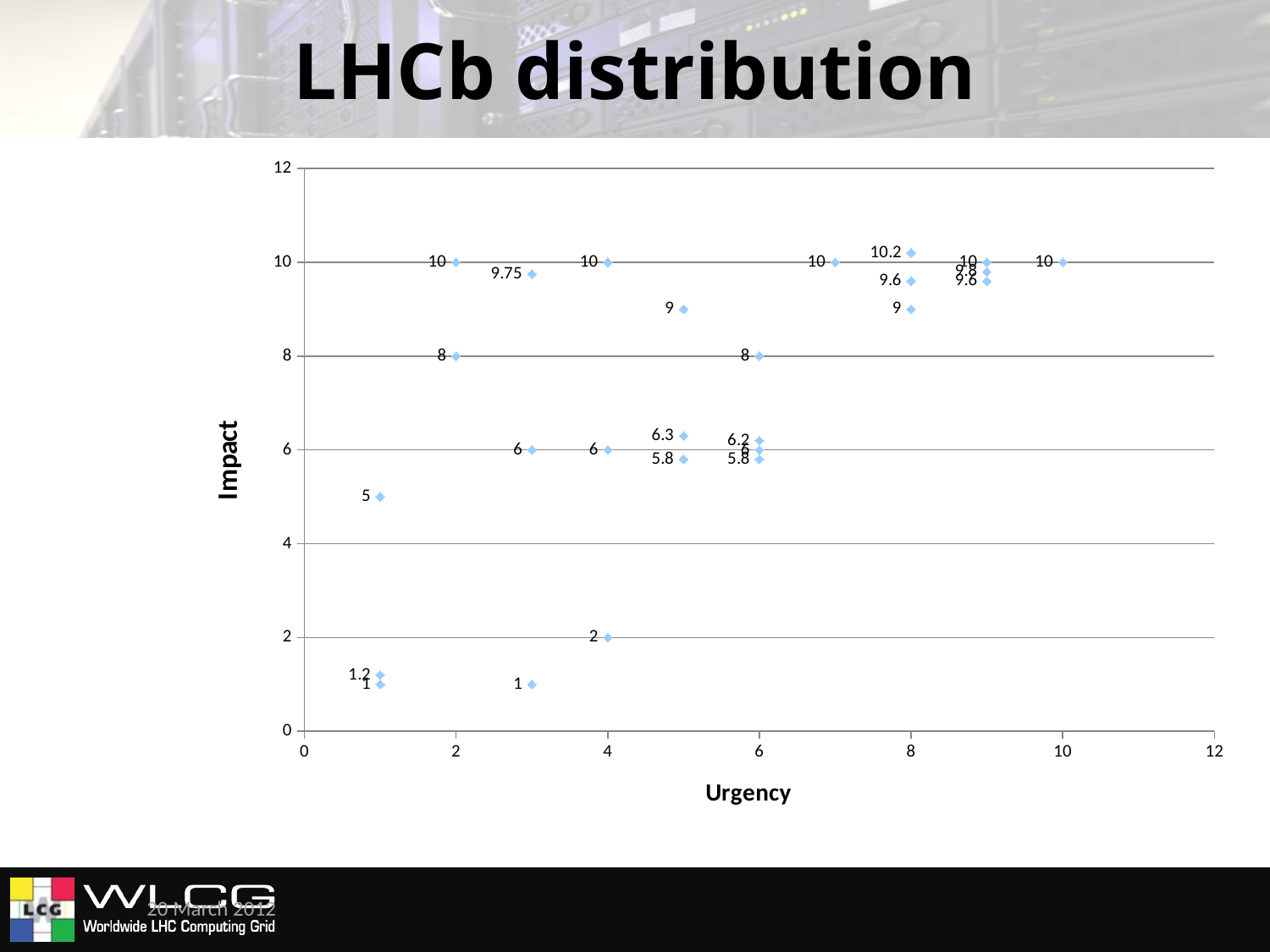
How many points are plotted at Urgency 6? 4 What is the title of the chart? LHCb distribution What is the Impact value of the point at Urgency 7? 10 Which is larger: the Impact of the point labelled 9.75 at Urgency 3 or the Impact of the point labelled 9 at Urgency 5? 9.75 at Urgency 3 At what Urgency value does the point with the highest Impact (10.2) appear? 8 Is the Impact value of the point at Urgency 1 labelled 5 greater or less than 4? greater What is the highest Impact value labelled at Urgency 5? 9 What is the difference between the Impact values 10.2 and 9.6 of the two highest points at Urgency 8? 0.6 What kind of chart is shown on the slide? scatter chart What are the x-axis and y-axis titles of the chart? Urgency and Impact What is the lowest Impact value labelled on the chart? 1 What is the highest Impact value labelled on the chart? 10.2